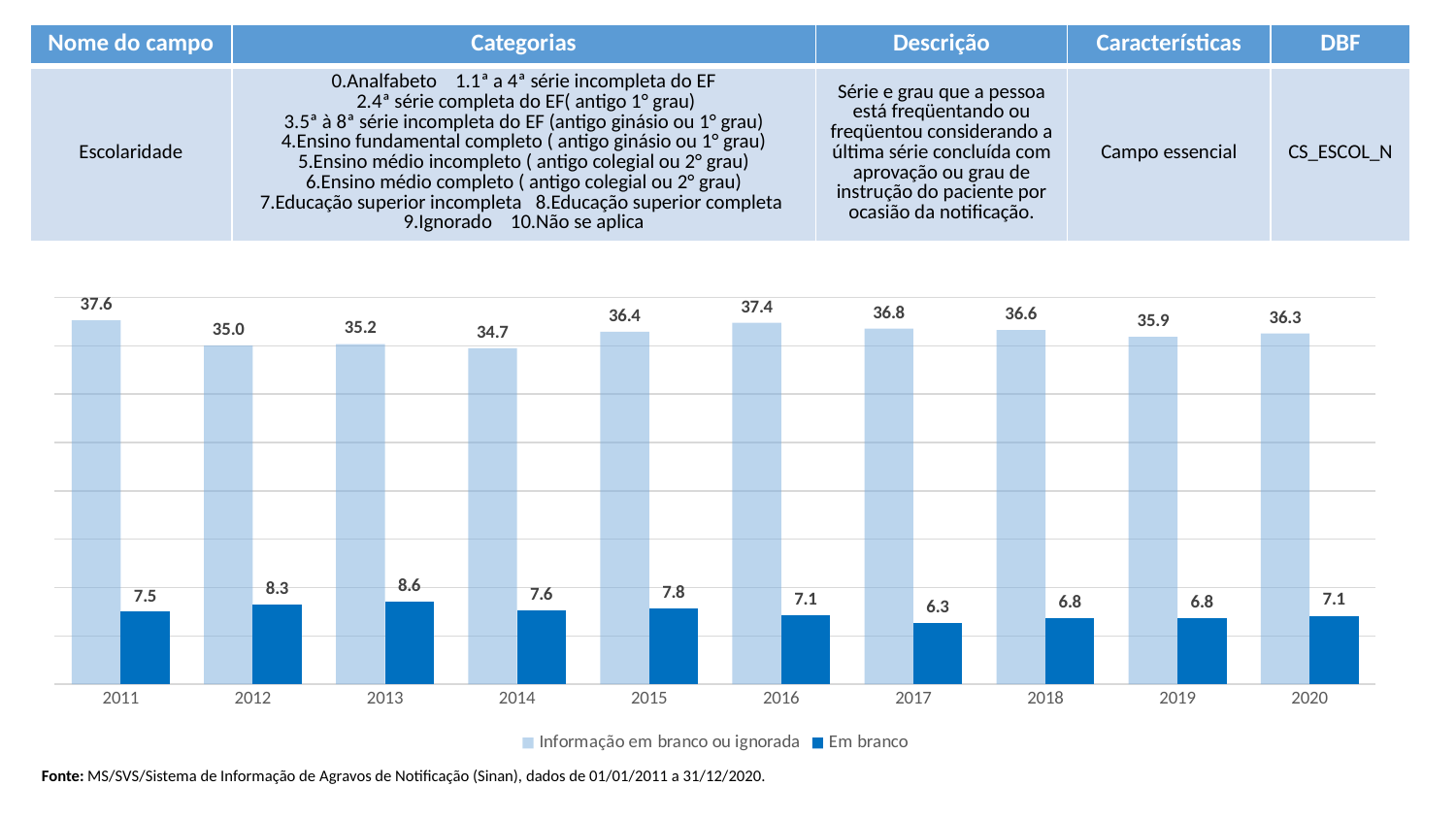
What is the value for 'Em branco' in 2017? 6.3 Which is larger: the 'Em branco' value in 2012 or in 2016? 2012 What is the value for 'Informação em branco ou ignorada' in 2011? 37.6 What type of chart is shown on the slide? bar chart In which year is 'Em branco' highest? 2013 Which series is shown in dark blue in the chart legend? Em branco How many years are shown on the x axis of the chart? 10 How many series does the chart legend list? 2 What is the value for 'Em branco' in 2013? 8.6 In which year is 'Em branco' lowest? 2017 What is the difference between the 'Informação em branco ou ignorada' values for 2011 and 2014? 2.9 In which year is 'Informação em branco ou ignorada' lowest? 2014